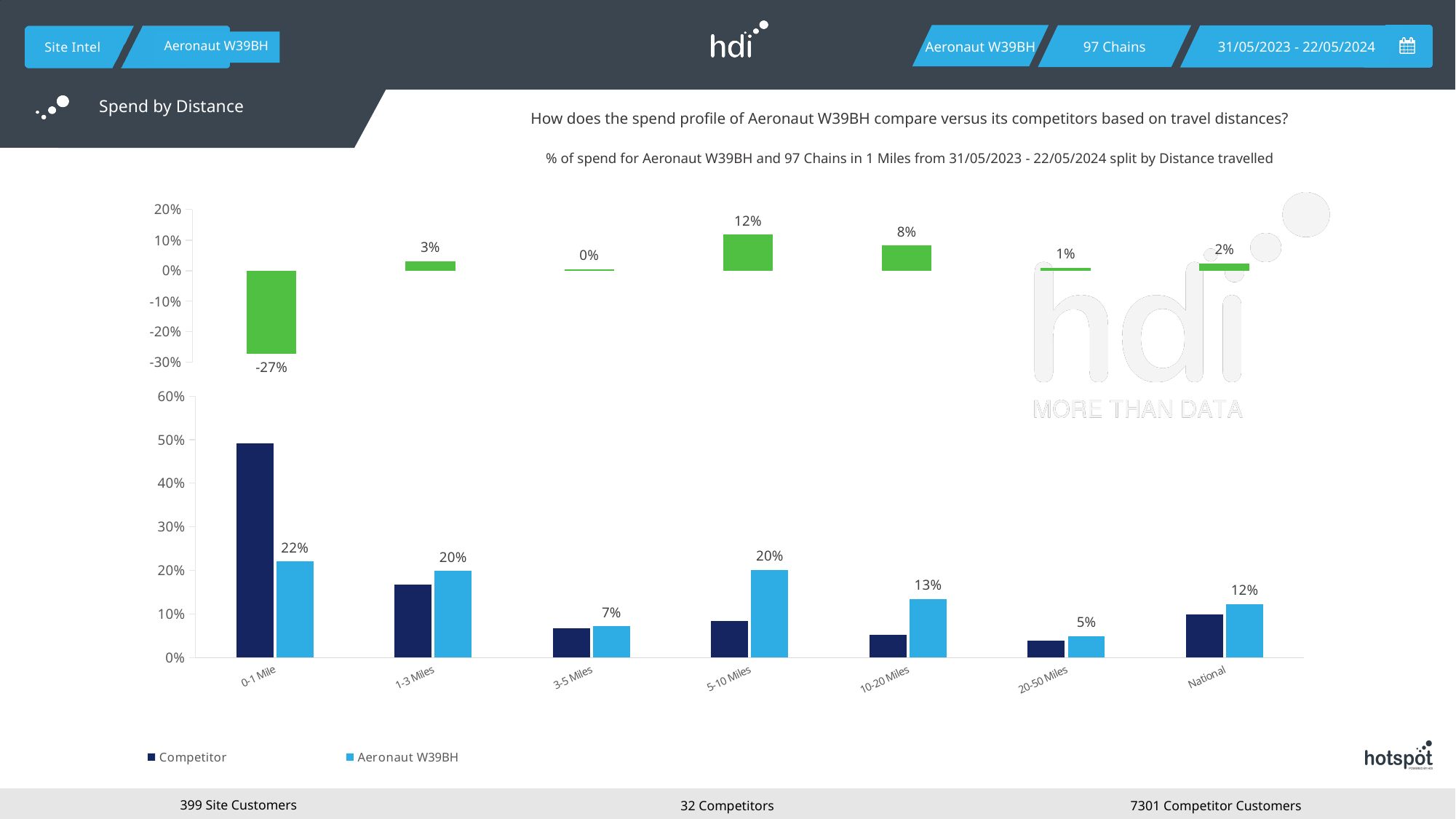
In the bottom bar chart, is the Competitor value for 0-1 Mile greater or less than 40%? greater In the bottom bar chart, what is the Aeronaut W39BH value for 0-1 Mile? 22% In the bottom bar chart, what is the Aeronaut W39BH value for 10-20 Miles? 13% How many distance bands are shown on the x axis of the bottom bar chart? 7 How many series does the legend of the bottom bar chart list? 2 In the top green chart, what is the value for 0-1 Mile? -27% In the bottom bar chart, for 0-1 Mile, which series has the larger value, Competitor or Aeronaut W39BH? Competitor In the top green chart, what is the value for 5-10 Miles? 12% In the bottom bar chart, what is the difference between the Aeronaut W39BH values for 0-1 Mile and 20-50 Miles? 17% In the bottom bar chart, which distance band has the lowest Aeronaut W39BH value? 20-50 Miles In the top green chart, which distance band has the highest value? 5-10 Miles What type of chart is the bottom chart? Bar chart